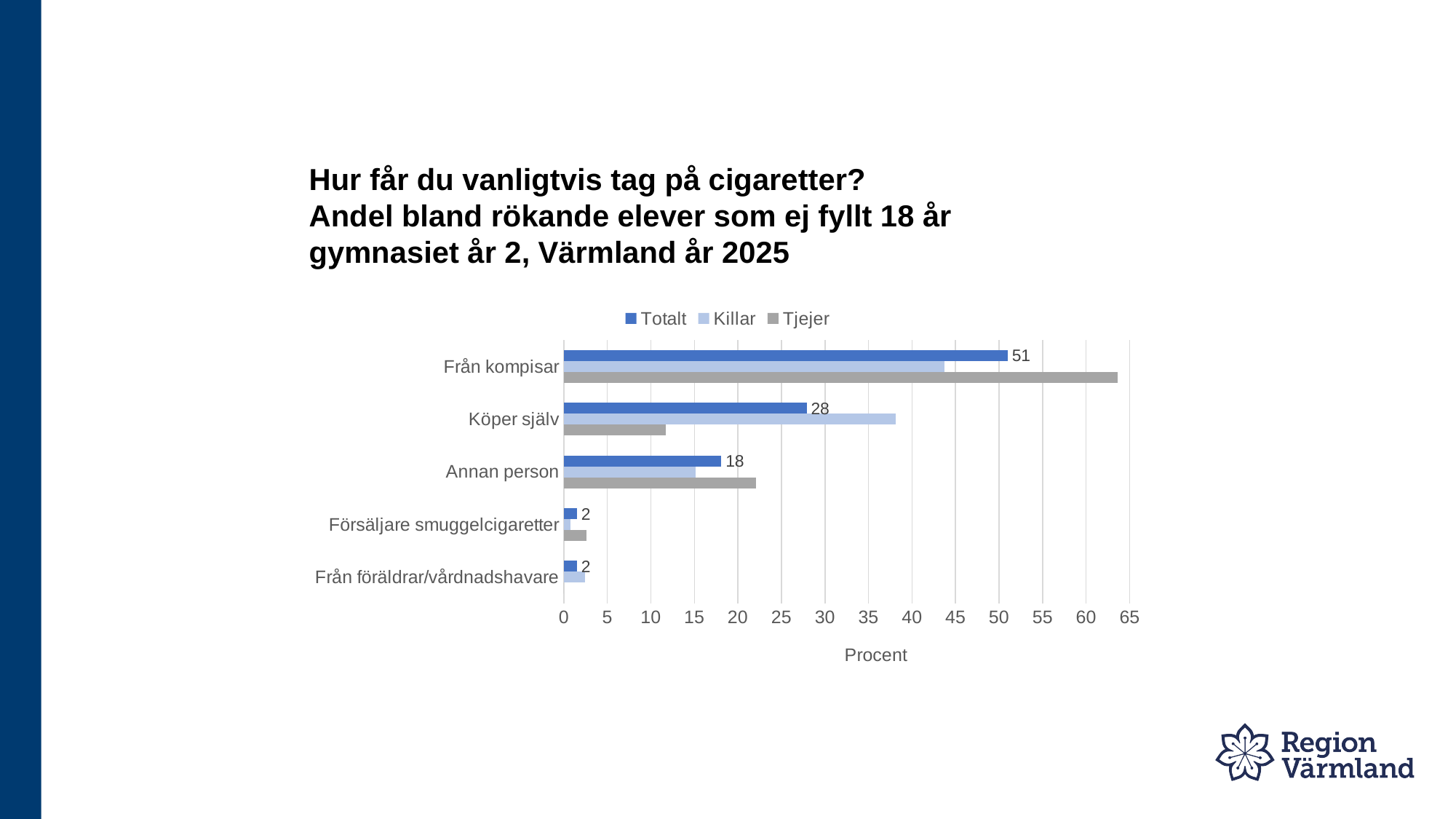
Is the Tjejer value for Från kompisar greater or less than 60? greater For Från kompisar, which is larger: the Killar value or the Tjejer value? Tjejer What is the Totalt value for Annan person? 18 What is the difference between the Totalt values for Köper själv and Annan person? 10 How many series does the legend list? 3 What is the Totalt value for Från kompisar? 51 How many categories are shown on the chart? 5 What is the difference between the Totalt values for Från kompisar and Köper själv? 23 What is the Totalt value for Köper själv? 28 What kind of chart is shown on the slide? bar chart Which category has the highest Totalt value? Från kompisar For Köper själv, which is larger: the Killar value or the Tjejer value? Killar